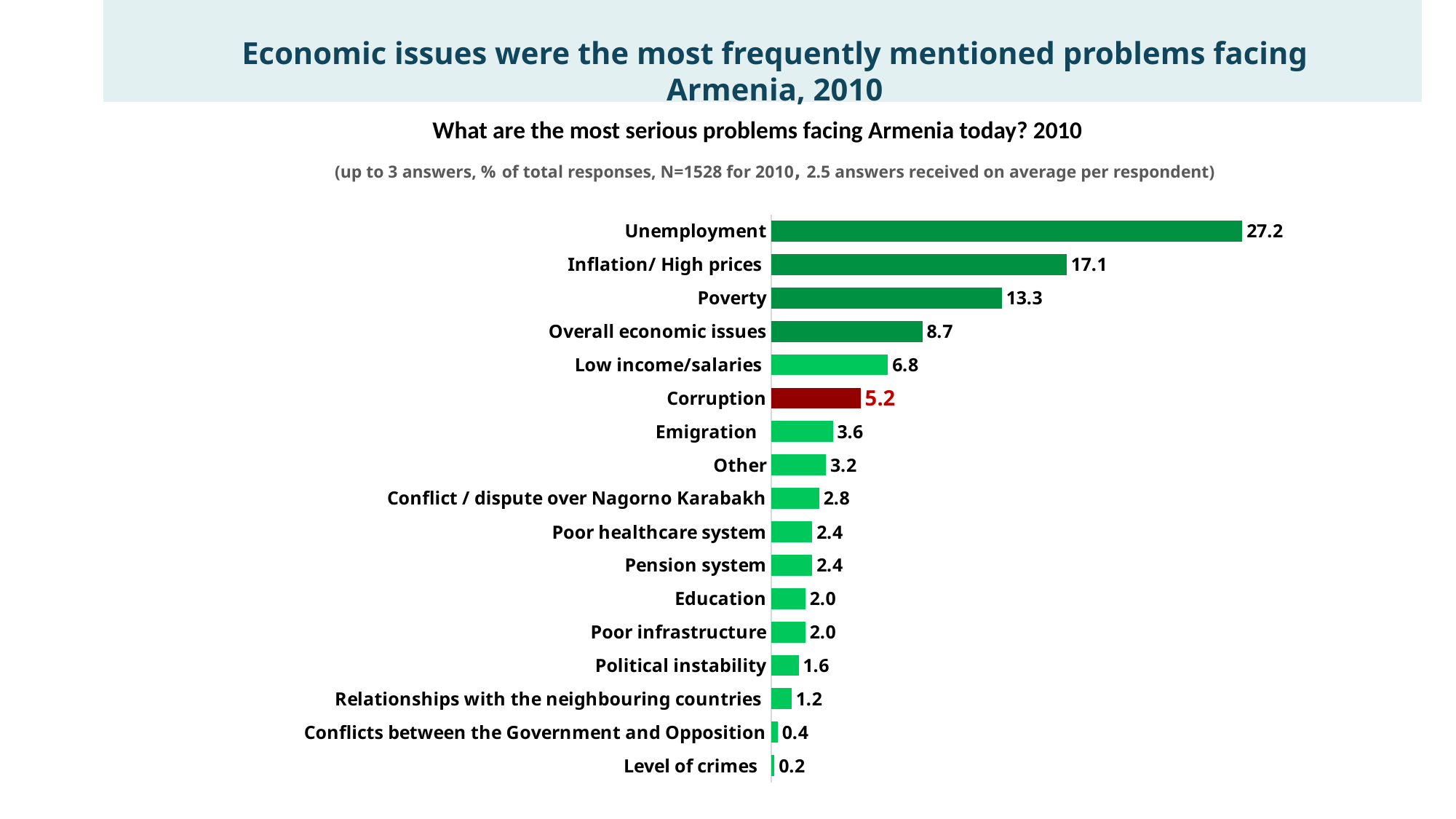
What is the difference between the values for Unemployment and Inflation/ High prices? 10.1 What is the difference between the values for Poverty and Overall economic issues? 4.6 What is the value for Corruption? 5.2 Which category's bar is coloured red? Corruption What is the value for Conflict / dispute over Nagorno Karabakh? 2.8 What is the value for Unemployment? 27.2 Which category has the highest value? Unemployment Which is larger, the value for Low income/salaries or the value for Corruption? Low income/salaries How many categories are shown in the chart? 17 Which category has the lowest value? Level of crimes What kind of chart is shown on the slide? Bar chart Which is larger, the value for Emigration or the value for Political instability? Emigration